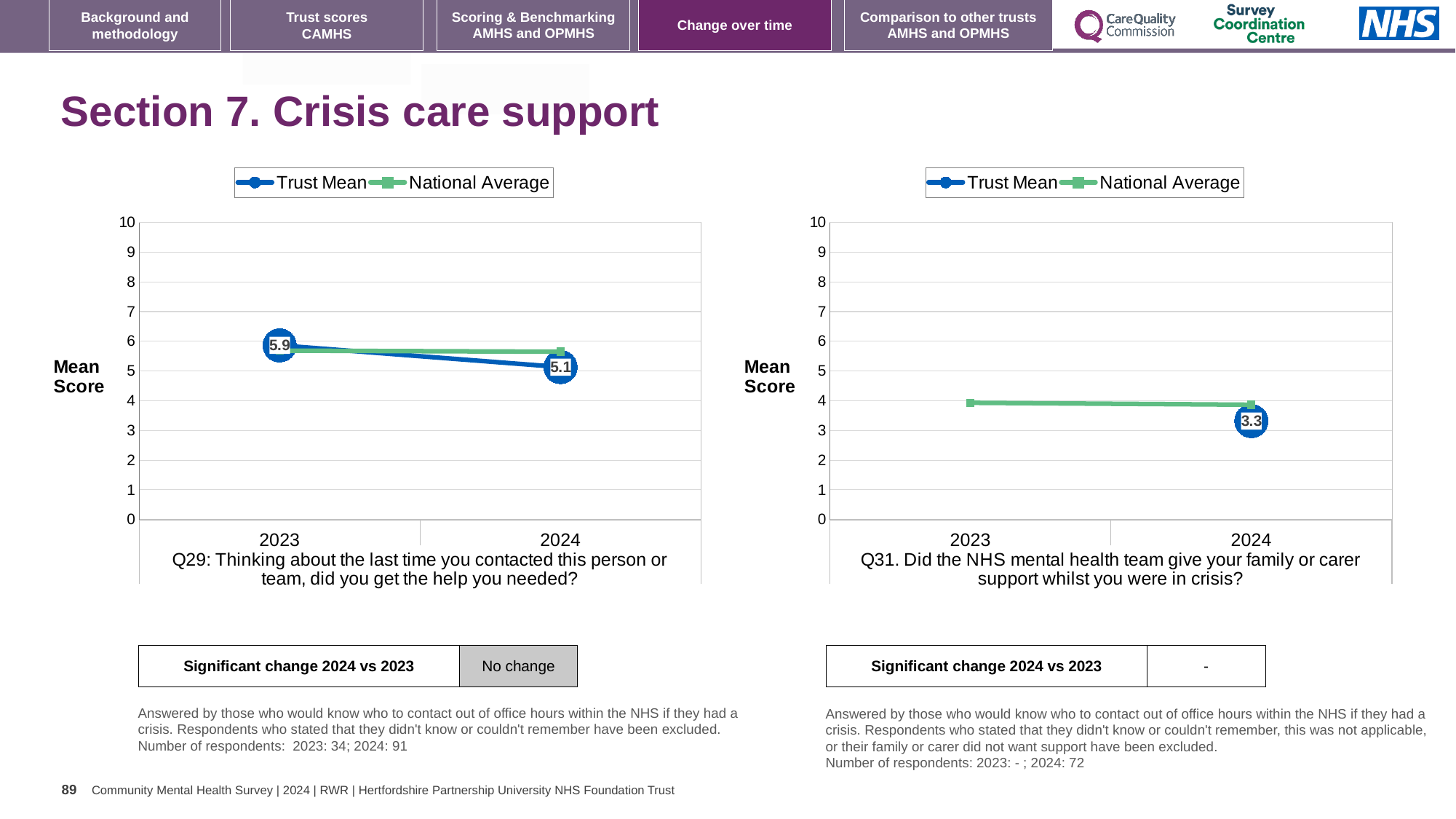
In the Q31 chart on the right, is the Trust Mean for 2024 greater or less than 4? less What type of chart is the Q31 chart on the right? line chart In the Q29 chart on the left, what is the Trust Mean score for 2023? 5.9 In the Q31 chart on the right, is the National Average for 2023 greater or less than 3? greater How many series does the legend of the Q29 chart on the left list? 2 In the Q29 chart on the left, does the Trust Mean rise or fall from 2023 to 2024? fall How many years are shown on the x axis of the Q29 chart on the left? 2 In the Q29 chart on the left, which year has the higher Trust Mean score, 2023 or 2024? 2023 In the Q29 chart on the left, is the National Average for 2024 greater or less than 5? greater In the Q29 chart on the left, by how much did the Trust Mean score change from 2023 to 2024? 0.8 In the Q29 chart on the left, what is the Trust Mean score for 2024? 5.1 In the Q31 chart on the right, what is the Trust Mean score for 2024? 3.3